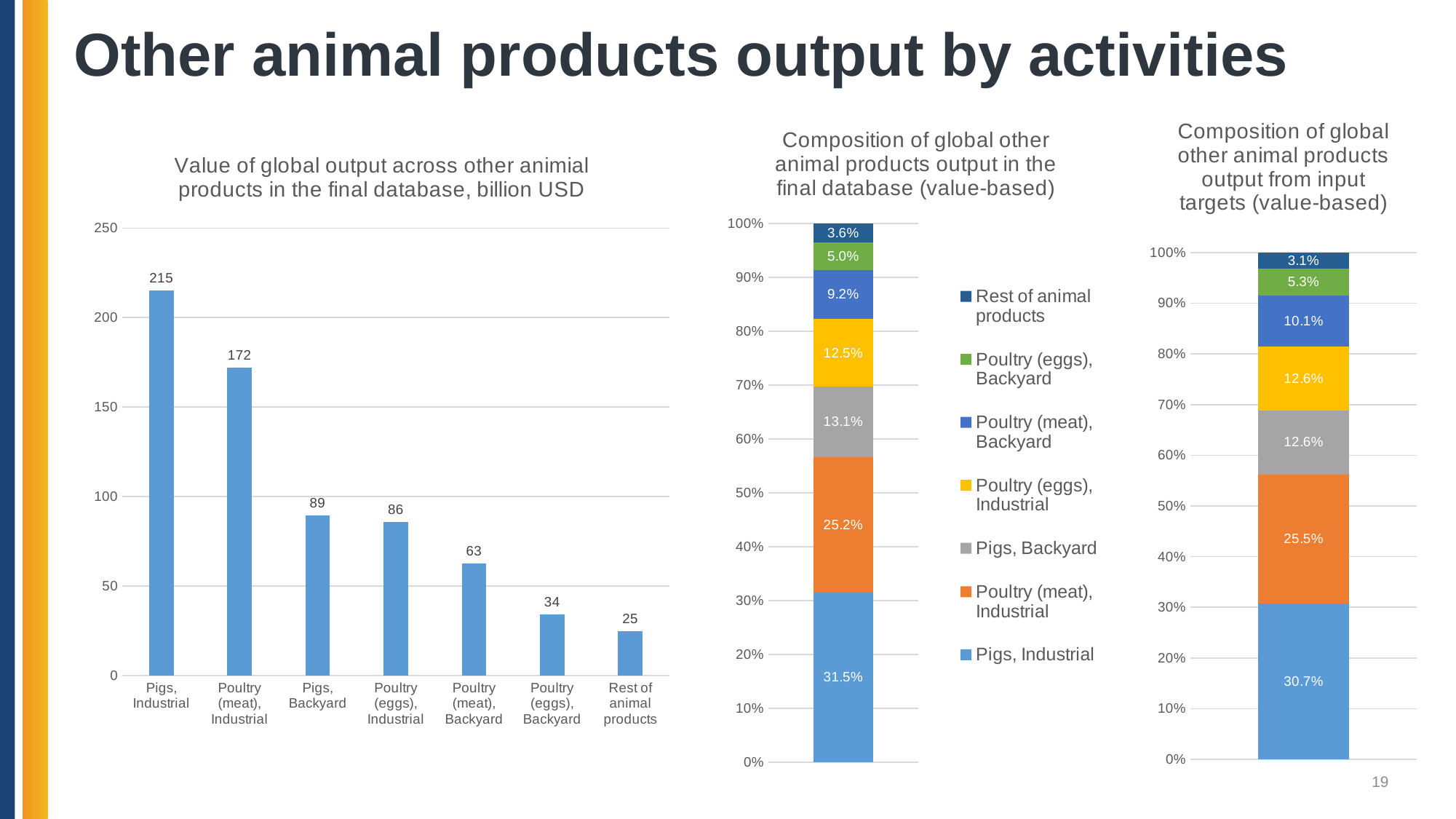
In the left chart 'Value of global output across other animial products in the final database, billion USD', which category has the lowest value? Rest of animal products What kind of chart is the left chart 'Value of global output across other animial products in the final database, billion USD'? Bar chart In the left chart 'Value of global output across other animial products in the final database, billion USD', do the values rise or fall moving from left to right along the x axis? Fall In the right chart 'Composition of global other animal products output from input targets (value-based)', what is the difference between the Pigs, Industrial segment and the Poultry (meat), Industrial segment? 5.2% In the middle chart 'Composition of global other animal products output in the final database (value-based)', what is the share for Poultry (meat), Industrial? 25.2% In the left chart 'Value of global output across other animial products in the final database, billion USD', how many categories are shown on the x axis? 7 In the left chart 'Value of global output across other animial products in the final database, billion USD', what is the value for Pigs, Industrial? 215 In the right chart 'Composition of global other animal products output from input targets (value-based)', what is the share for Poultry (meat), Backyard? 10.1% In the middle chart 'Composition of global other animal products output in the final database (value-based)', which segment is the largest? Pigs, Industrial In the left chart 'Value of global output across other animial products in the final database, billion USD', what is the difference between Pigs, Industrial and Poultry (meat), Industrial? 43 In the left chart 'Value of global output across other animial products in the final database, billion USD', which is larger: Poultry (meat), Backyard or Poultry (eggs), Backyard? Poultry (meat), Backyard In the middle chart 'Composition of global other animal products output in the final database (value-based)', how many series does the legend list? 7